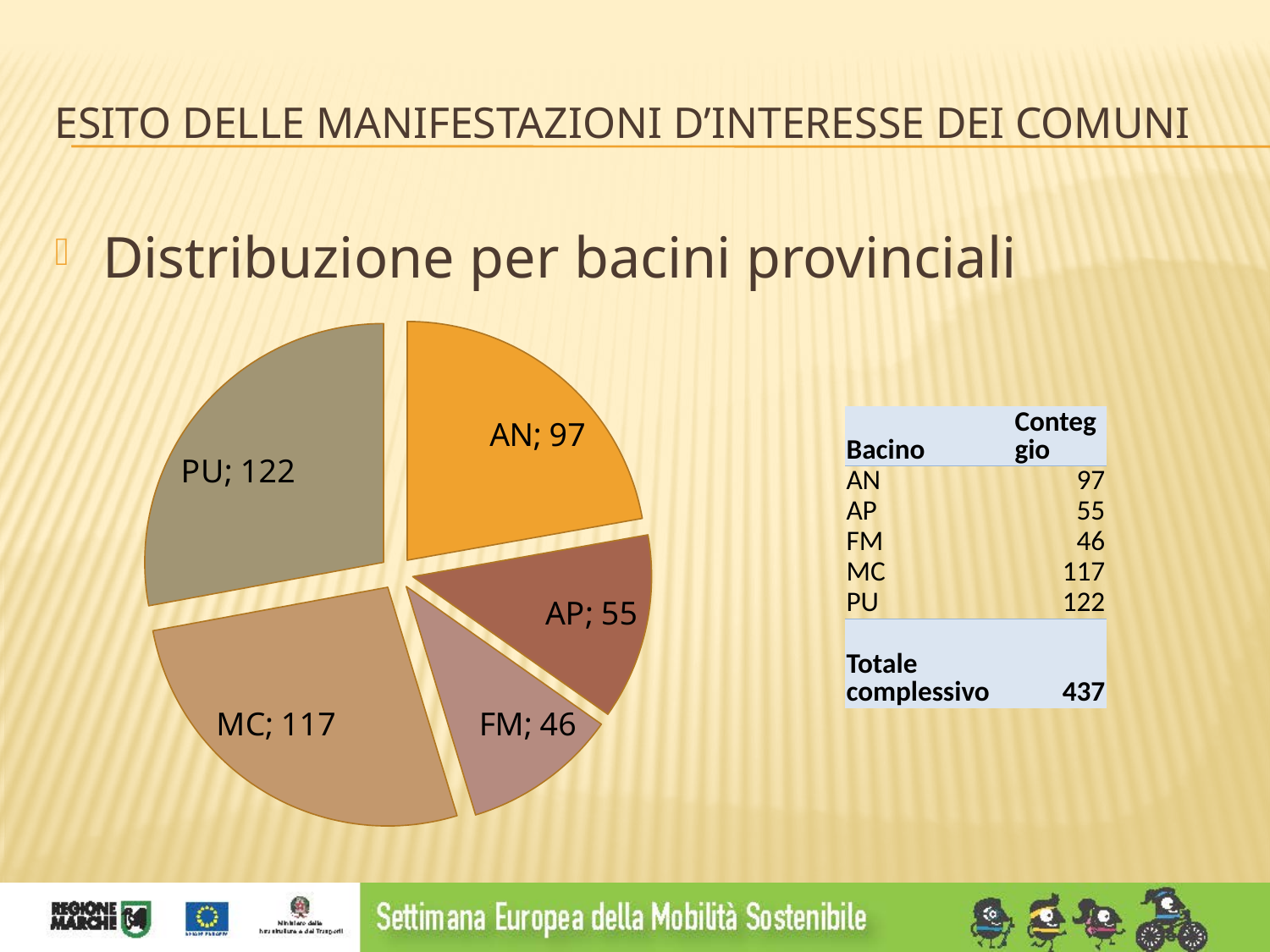
What is the difference between the values for AP and FM? 9 What kind of chart is shown on the slide? pie chart Which bacino has the smallest slice in the pie chart? FM What colour is the AN slice in the pie chart? orange What is the total of all the slices in the pie chart? 437 What is the difference between the values for MC and AN? 20 What is the value for PU in the pie chart? 122 How many slices does the pie chart have? 5 What is the value for FM in the pie chart? 46 Which bacino has the largest slice in the pie chart? PU Which is larger, the value for AN or the value for AP? AN What is the value for AP in the pie chart? 55